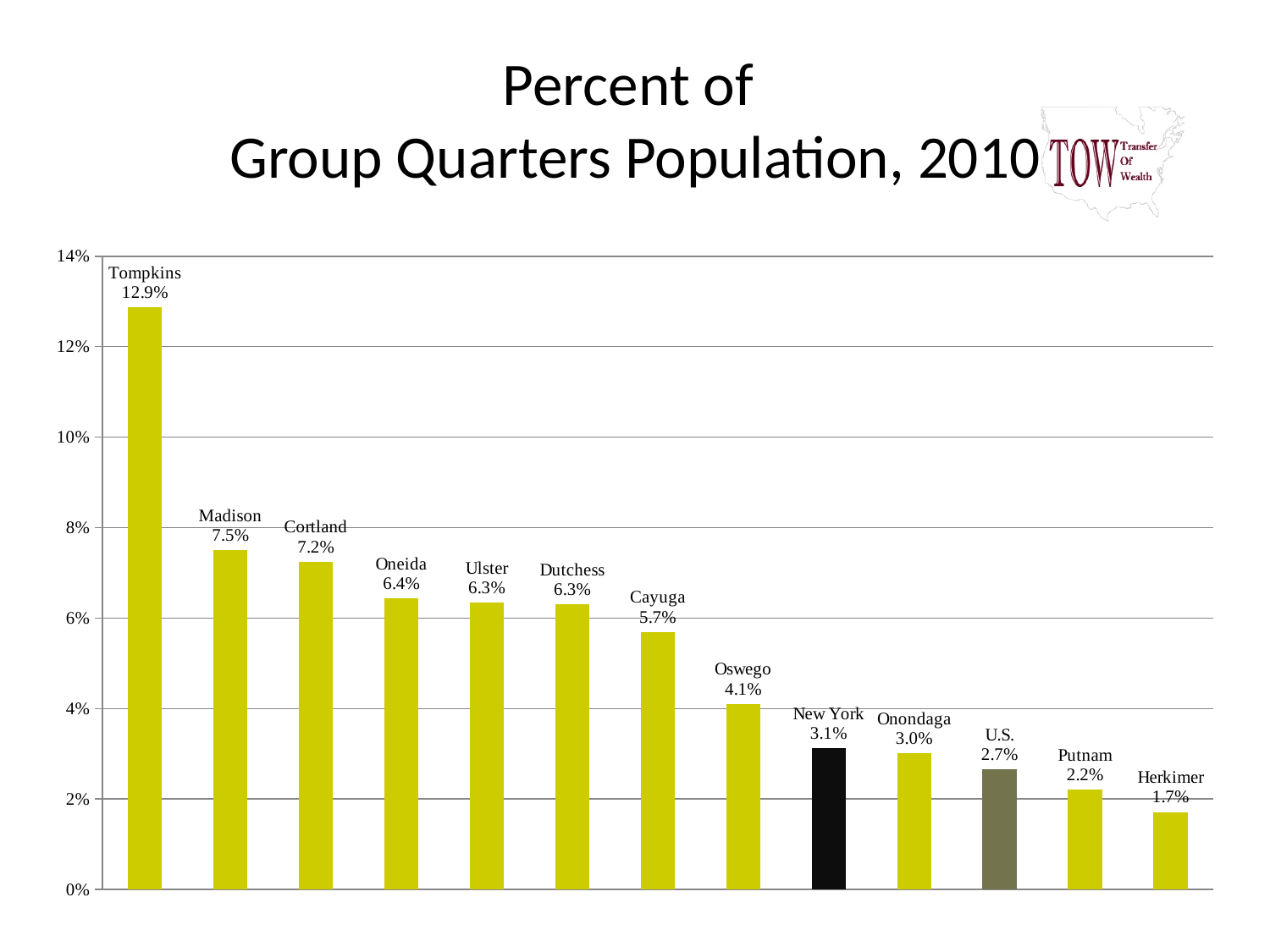
What kind of chart is shown on the slide? bar chart What is the value shown for Oswego? 4.1% What is the percent of group quarters population for Tompkins? 12.9% Which is larger, the value for Oneida or the value for Cayuga? Oneida Which category has the highest percent of group quarters population? Tompkins What is the difference between the values for Madison and Cortland? 0.3% What is the difference between the values for Tompkins and Herkimer? 11.2% How many bars are plotted on the chart? 13 What is the value shown for the U.S.? 2.7% Which category has the lowest percent of group quarters population? Herkimer Do the values rise or fall from left to right along the x axis? fall Is the value for New York greater or less than 4%? less